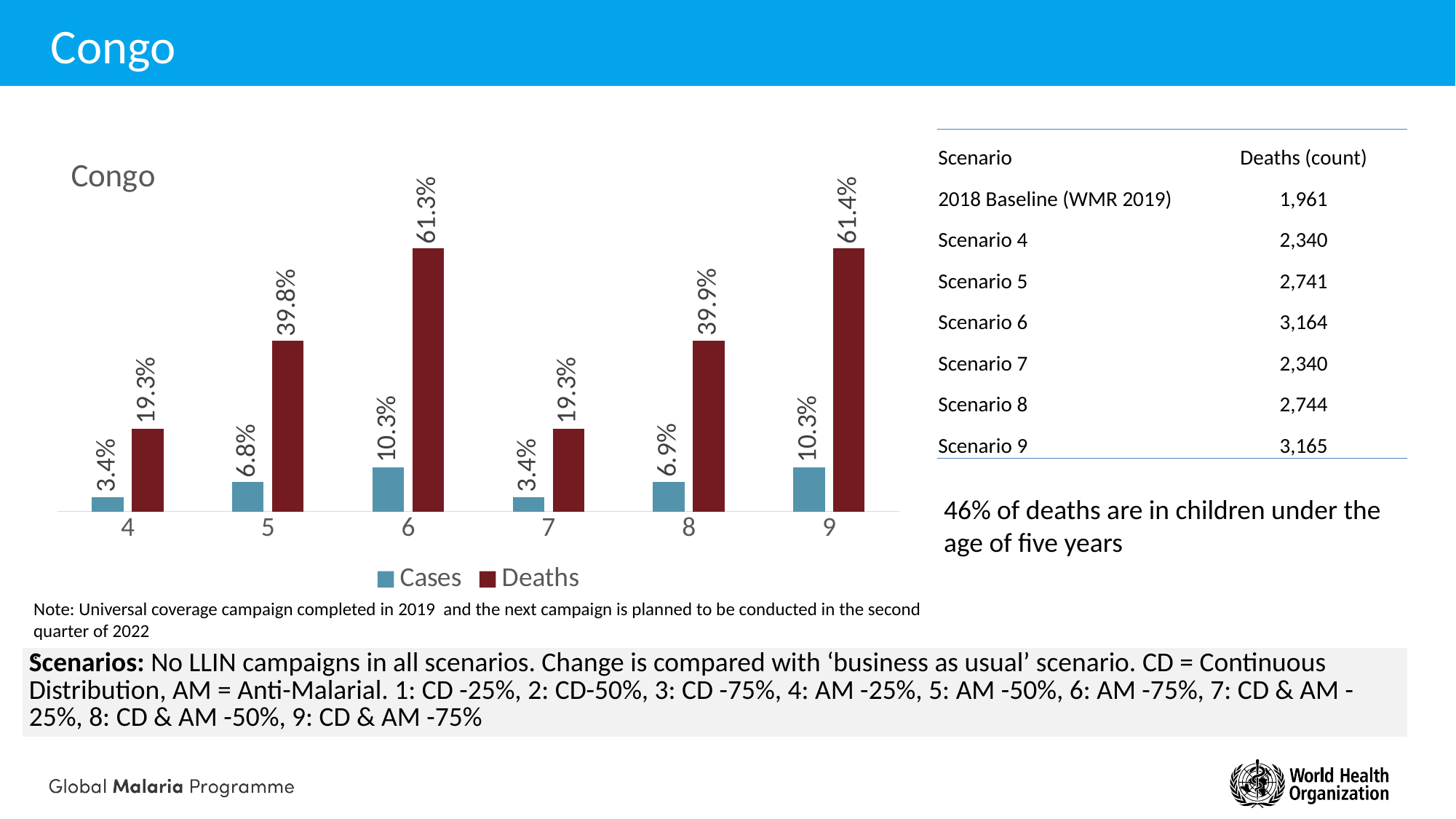
What is the Cases value for scenario 6? 10.3% Which scenario has the highest Deaths value? 9 How many scenarios are shown on the x axis of the chart? 6 What kind of chart is shown on the slide? Bar chart Which scenario has the lowest Cases value, 4 or 5? 4 What is the title of the chart? Congo Is the Deaths value for scenario 8 larger than the Deaths value for scenario 7? Yes What is the difference between the Deaths value and the Cases value for scenario 6? 51.0% What is the Deaths value for scenario 7? 19.3% How many series does the chart legend list? 2 What is the Deaths value for scenario 5? 39.8% What is the Cases value for scenario 8? 6.9%